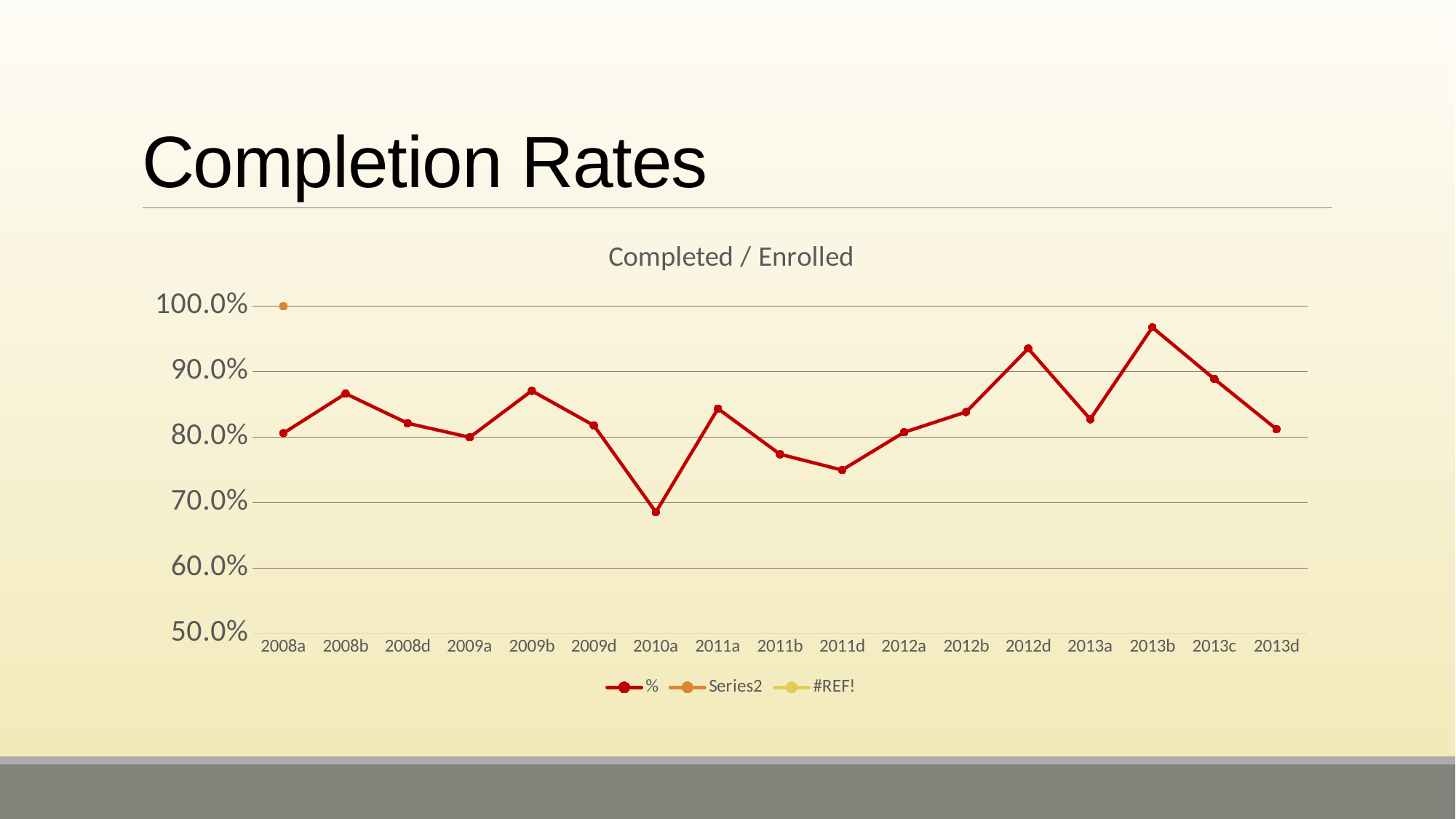
Which category has the highest value for the % series? 2013b Which category has the lowest value for the % series? 2010a How many categories are shown on the x axis? 17 Which is larger for the % series, the value at 2012d or the value at 2013b? 2013b Is the value for the % series at 2010a greater or less than 70.0%? less Does the % series rise or fall from 2011d to 2012d? rise What is the value of the Series2 point at 2008a? 100.0% What type of chart is shown on the slide? line chart How many series does the legend list? 3 What is the title of the chart? Completed / Enrolled Is the value for the % series at 2011d greater or less than 80.0%? less Is the value for the % series at 2012d greater or less than 90.0%? greater